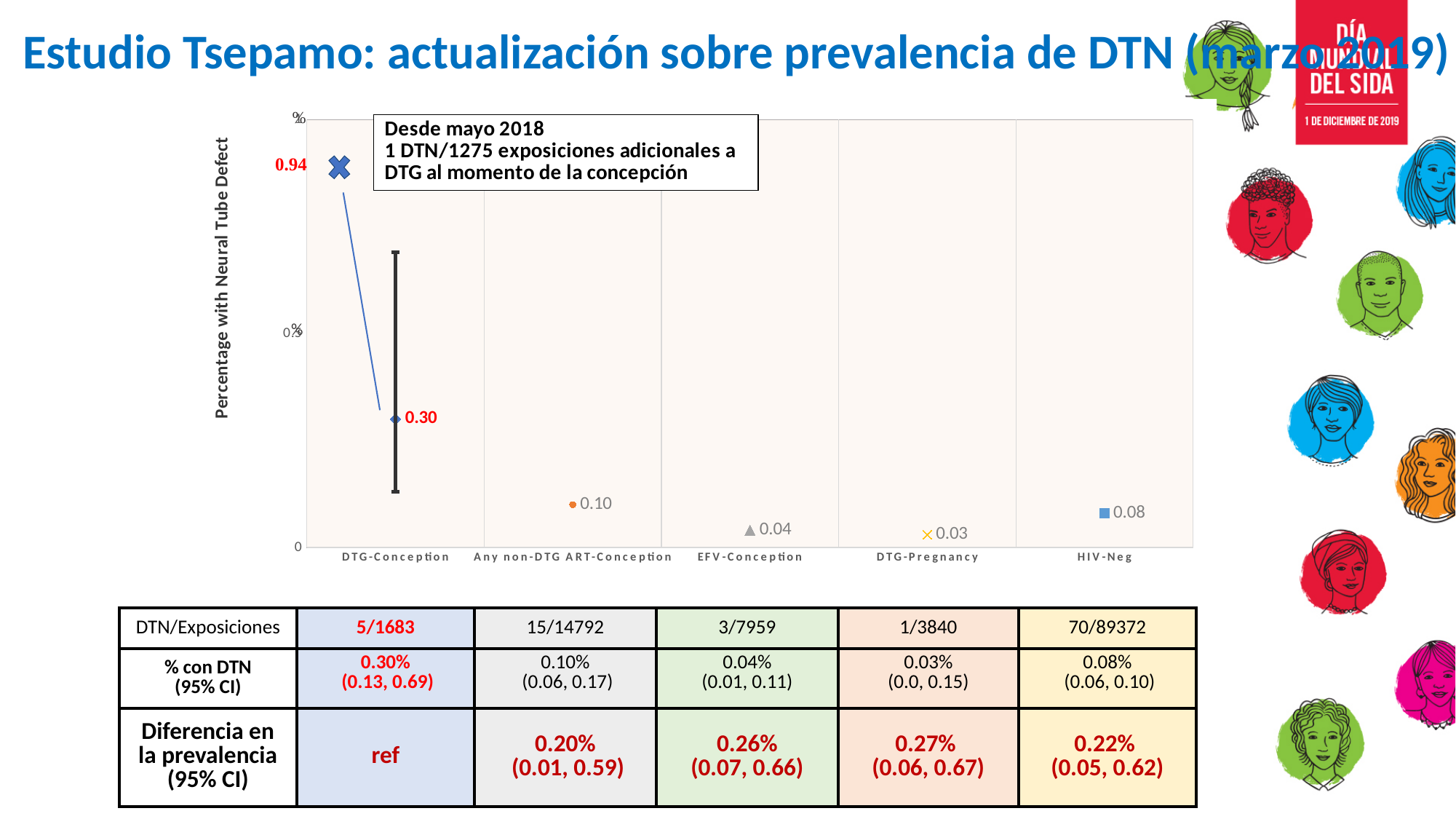
What is the plotted value for DTG-Conception? 0.30 Which category has the highest current plotted value? DTG-Conception Which is larger, the value for Any non-DTG ART-Conception or the value for HIV-Neg? Any non-DTG ART-Conception Which category has the lowest plotted value? DTG-Pregnancy What is the plotted value for EFV-Conception? 0.04 What was the earlier DTG-Conception value marked with the large X on the chart? 0.94 What is the plotted value for HIV-Neg? 0.08 How many categories are shown on the x axis of the chart? 5 What is the plotted value for DTG-Pregnancy? 0.03 What is the plotted value for Any non-DTG ART-Conception? 0.10 What is the difference between the DTG-Conception value (0.30) and the HIV-Neg value (0.08)? 0.22 What is the label of the chart's y axis? Percentage with Neural Tube Defect